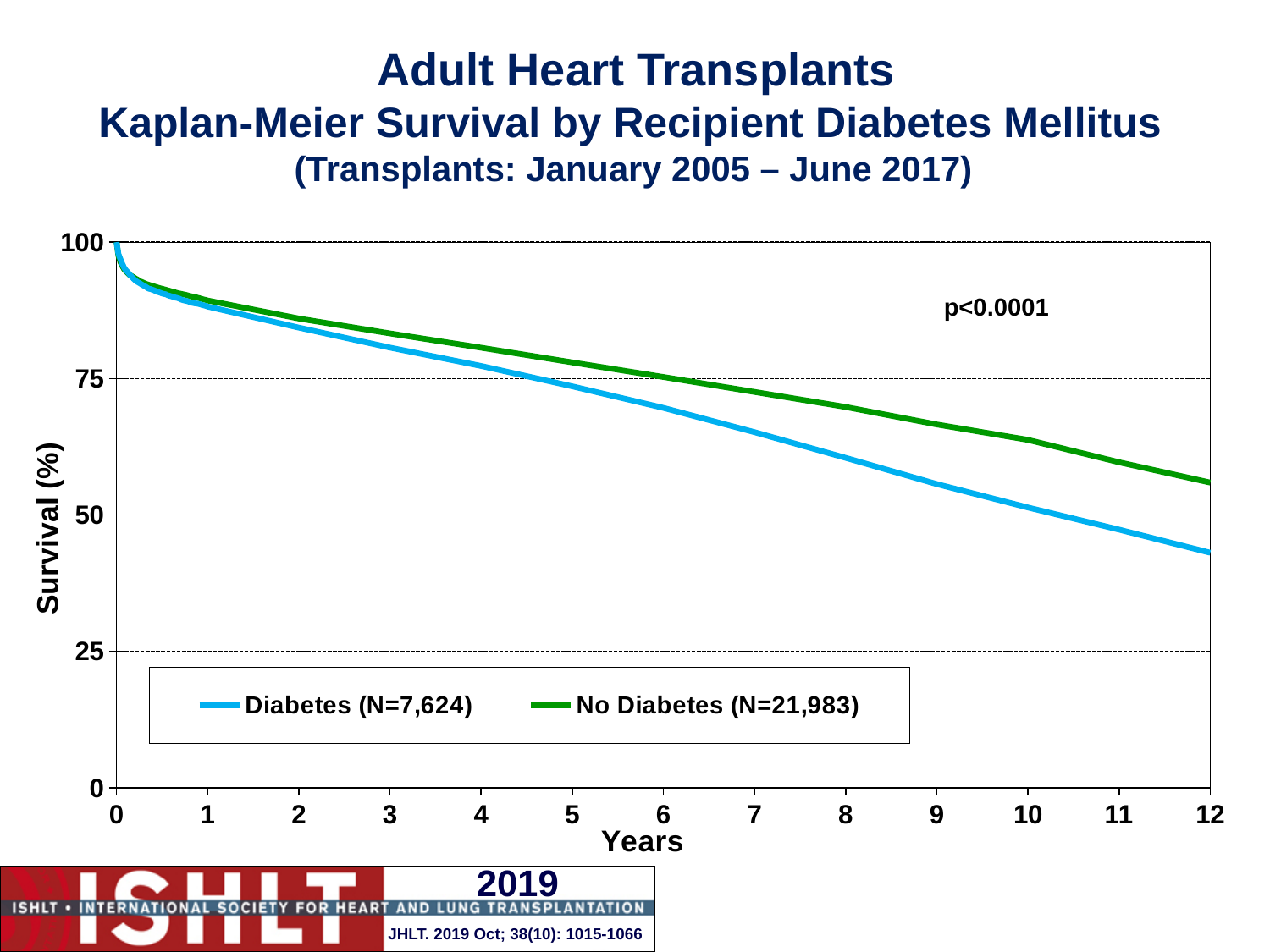
Is the survival value for the Diabetes group at 2 years greater or less than 75? greater Is the survival value for the Diabetes group at 6 years greater or less than 75? less How many series does the legend list? 2 Do the survival curves rise or fall as years increase? fall At 8 years, which group has lower survival: Diabetes or No Diabetes? Diabetes Is the survival value for the No Diabetes group at 4 years greater or less than 75? greater At 12 years, which group has higher survival: Diabetes or No Diabetes? No Diabetes What is the N for the Diabetes group shown in the legend? 7,624 What kind of chart is shown on the slide? line chart What p-value is printed on the chart? p<0.0001